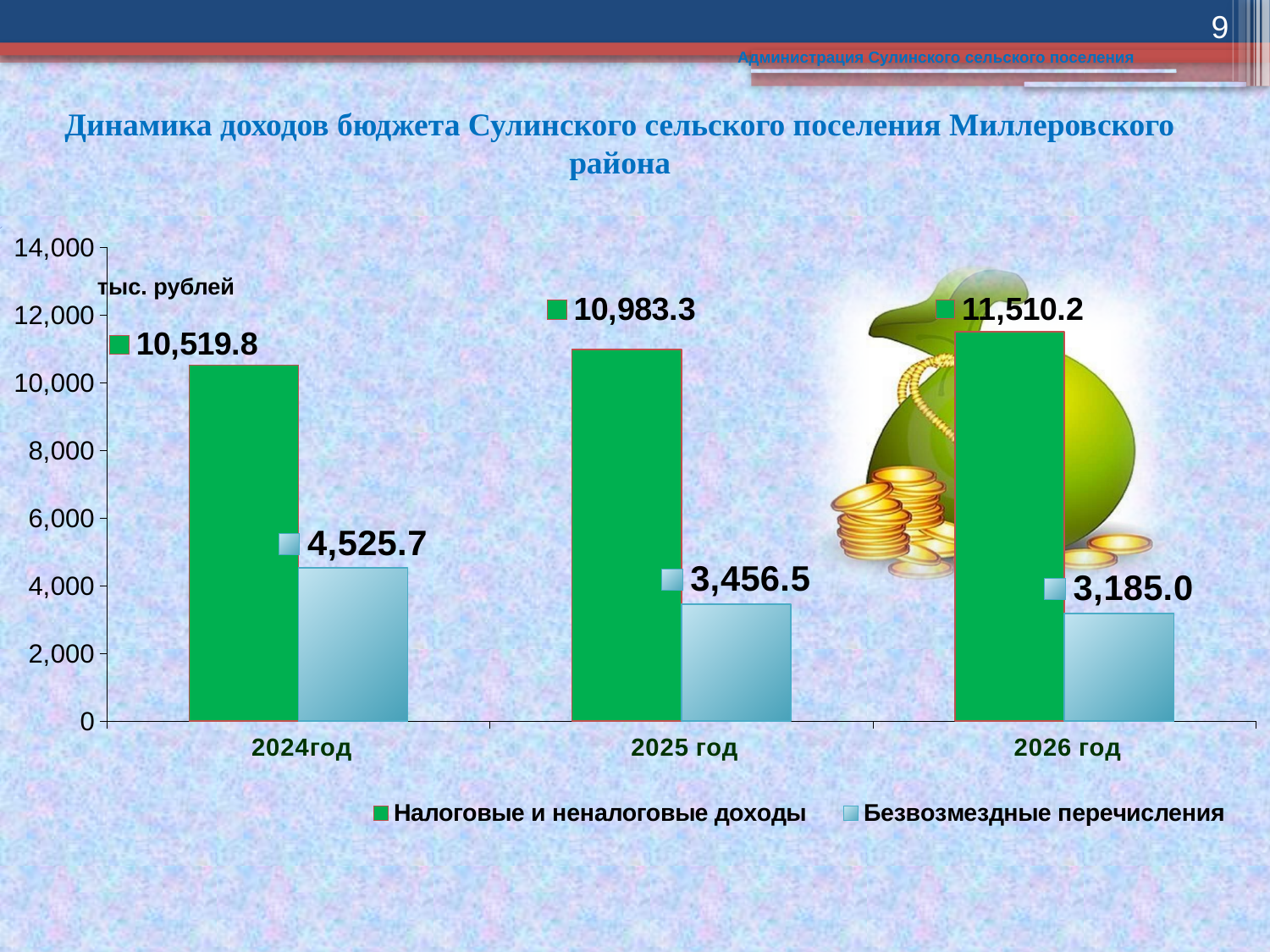
In which year is Безвозмездные перечисления lowest? 2026 год What is the value of Безвозмездные перечисления for 2026 год? 3,185.0 What is the value of Налоговые и неналоговые доходы for 2024год? 10,519.8 How many years are shown on the x axis? 3 Does Налоговые и неналоговые доходы rise or fall from 2024год to 2026 год? rise Which is larger in 2025 год: Налоговые и неналоговые доходы or Безвозмездные перечисления? Налоговые и неналоговые доходы What is the difference between Безвозмездные перечисления in 2024год and in 2026 год? 1,340.7 Is the value of Безвозмездные перечисления for 2024год greater or less than 4,000? greater How many series does the legend list? 2 In which year is Налоговые и неналоговые доходы highest? 2026 год What is the value of Безвозмездные перечисления for 2025 год? 3,456.5 What is the difference between Налоговые и неналоговые доходы in 2026 год and in 2024год? 990.4